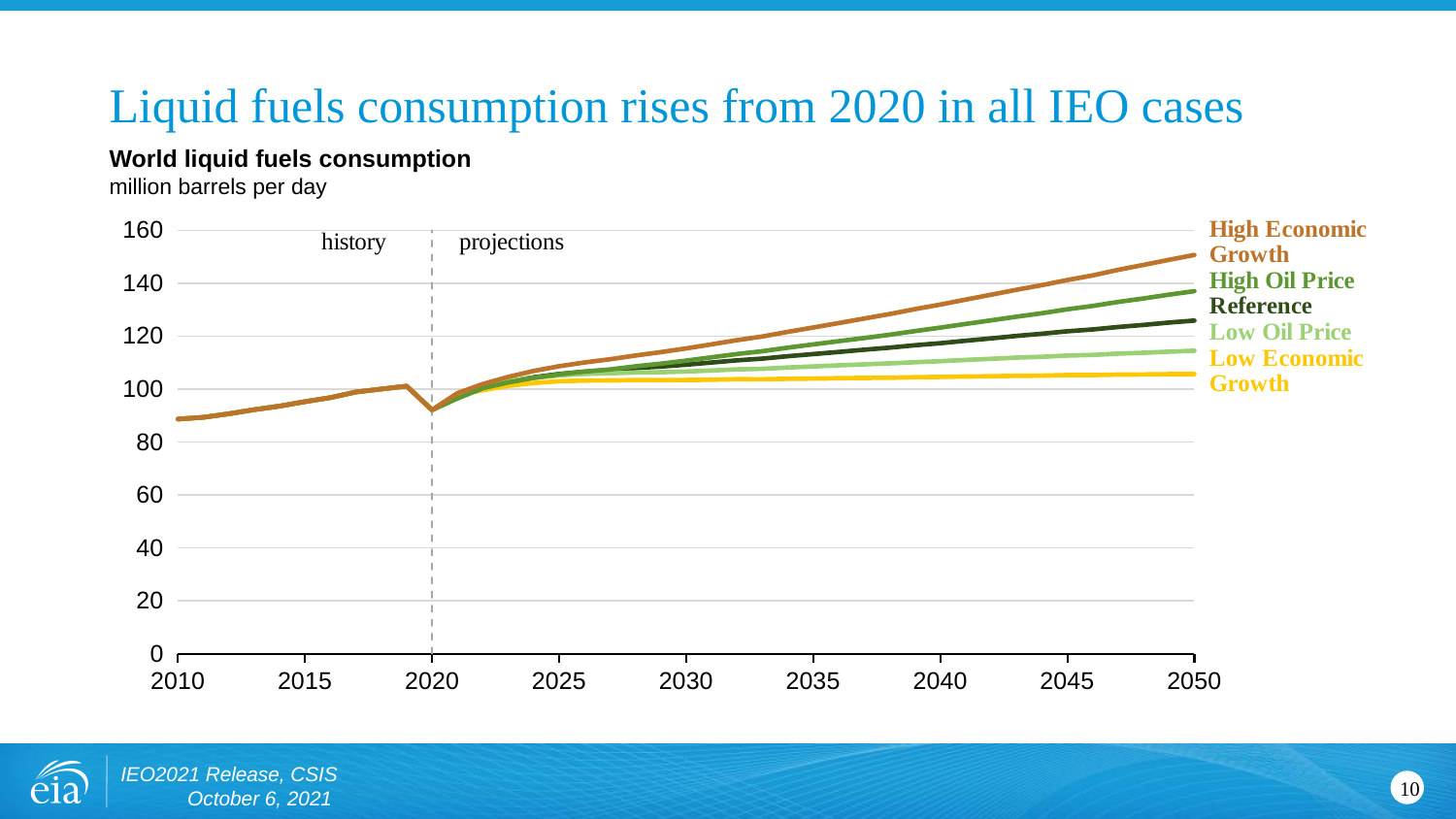
Is the value for the High Economic Growth case in 2050 greater or less than 140? greater Is the value for the Reference case in 2050 greater or less than 120? greater Which case has the highest world liquid fuels consumption in 2050? High Economic Growth In 2050, which is larger: the Reference case or the Low Oil Price case? Reference In which year does the dashed line separating history from projections appear? 2020 Is the value for the Low Economic Growth case in 2050 greater or less than 120? less What kind of chart is shown on the slide? line chart Do the projected values rise or fall from 2020 to 2050 in the High Oil Price case? rise What unit is the chart measured in? million barrels per day How many series (cases) does the chart show? 5 Which case has the lowest world liquid fuels consumption in 2050? Low Economic Growth